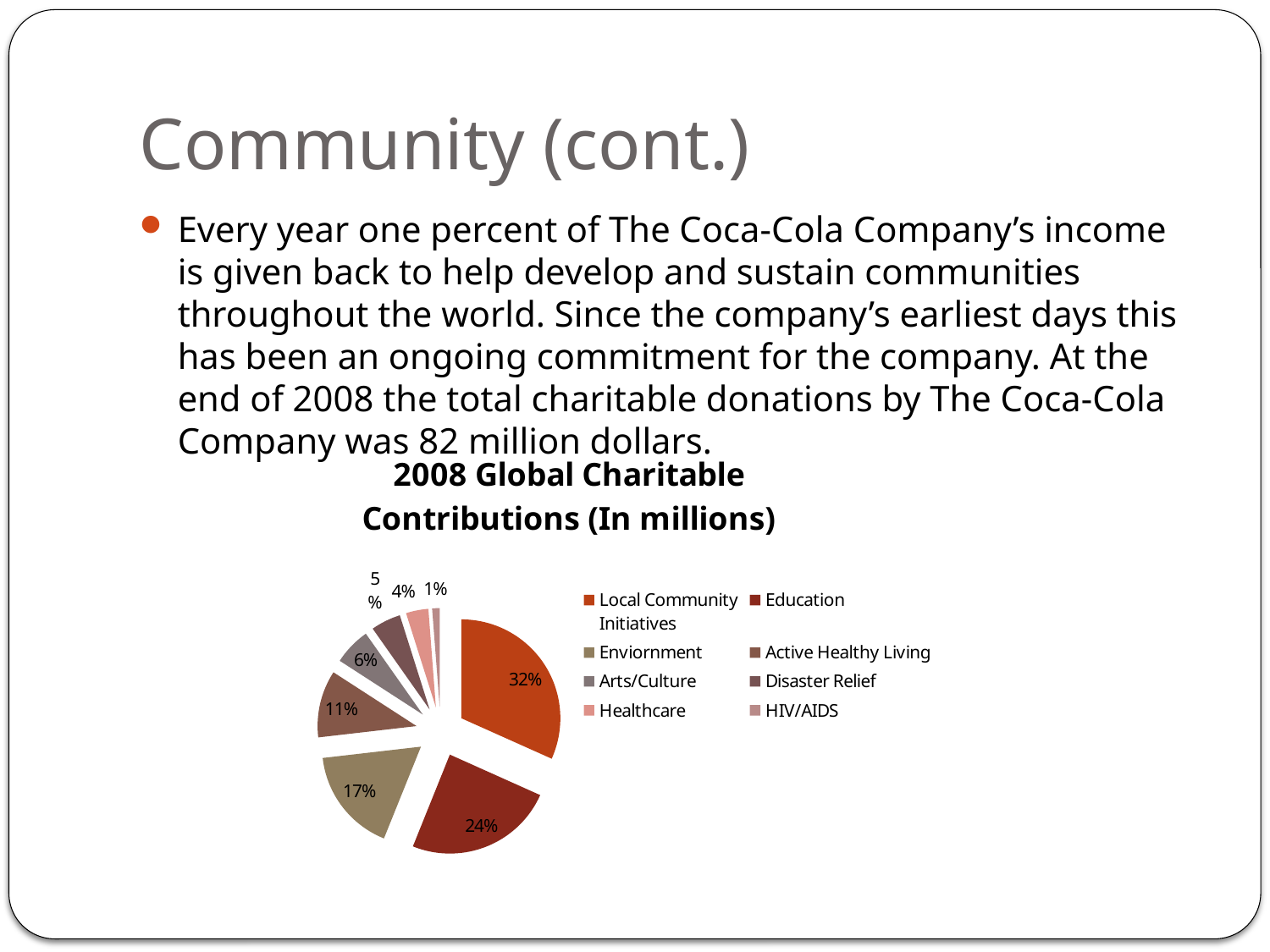
What is the title of the chart? 2008 Global Charitable Contributions (In millions) What kind of chart is shown on the slide? pie chart What percentage is shown for Healthcare? 4% Which is larger, the share for Arts/Culture or the share for Disaster Relief? Arts/Culture What percentage is shown for Active Healthy Living? 11% What percentage is shown for Enviornment? 17% How many categories does the legend list? 8 Which category has the largest slice of the pie? Local Community Initiatives What is the difference in percentage points between Local Community Initiatives and Education? 8 Which category has the smallest slice of the pie? HIV/AIDS What share of the pie does Local Community Initiatives represent? 32% What percentage is shown for Education? 24%